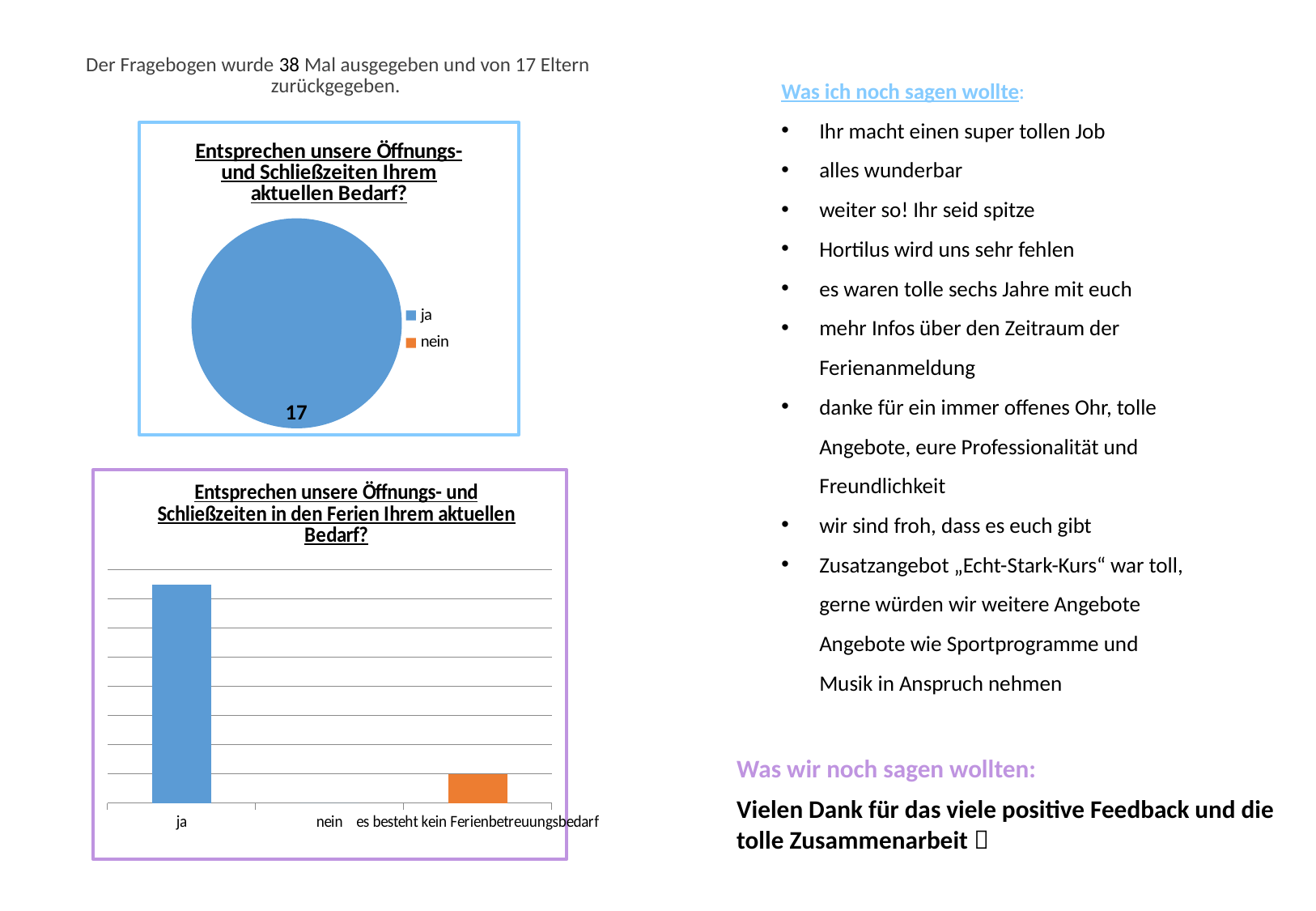
In the bottom bar chart, how many categories are shown on the x axis? 3 In the top pie chart, what colour is the "ja" slice? blue What kind of chart is the top chart titled "Entsprechen unsere Öffnungs- und Schließzeiten Ihrem aktuellen Bedarf?"? pie chart What kind of chart is the bottom chart titled "Entsprechen unsere Öffnungs- und Schließzeiten in den Ferien Ihrem aktuellen Bedarf?"? bar chart In the top pie chart, what value is printed on the "ja" slice? 17 In the bottom bar chart, which category has the highest bar? ja In the bottom bar chart, which category has the lowest value? nein In the bottom bar chart, which is larger: the value for "ja" or the value for "es besteht kein Ferienbetreuungsbedarf"? ja In the top pie chart, how many entries does the legend list? 2 In the bottom bar chart, what colour is the bar for "es besteht kein Ferienbetreuungsbedarf"? orange In the top pie chart, which category has the largest slice? ja